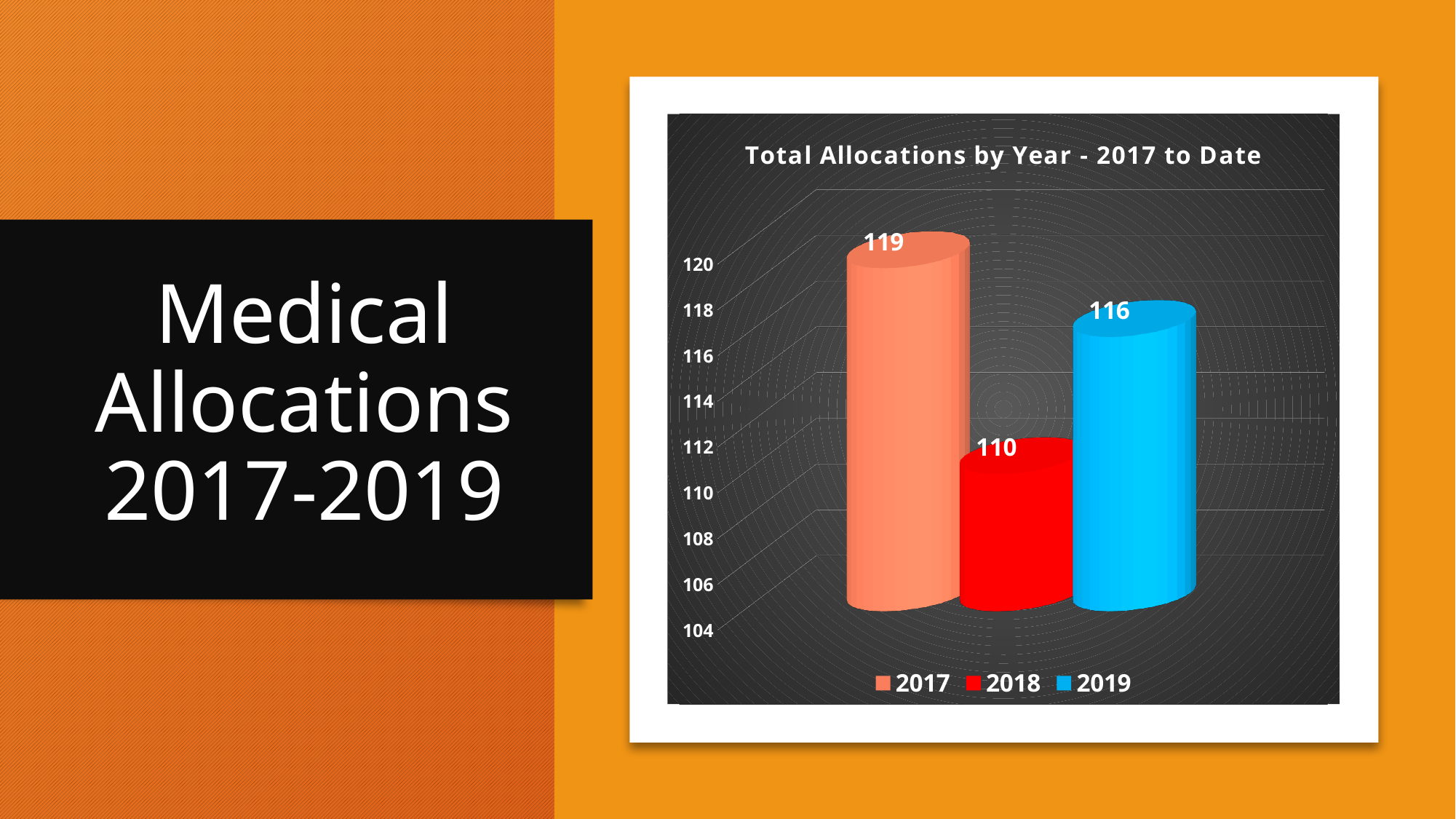
What is the difference between the values for 2019 and 2018? 6 What is the value for 2017? 119 What is the title of the chart? Total Allocations by Year - 2017 to Date How many series does the legend list? 3 What is the value for 2019? 116 What is the value for 2018? 110 What kind of chart is shown on the slide? bar chart What is the difference between the values for 2017 and 2018? 9 What colour is the bar for 2018? red Which is larger, the value for 2019 or the value for 2018? 2019 Which year has the highest total allocations? 2017 Which year has the lowest total allocations? 2018